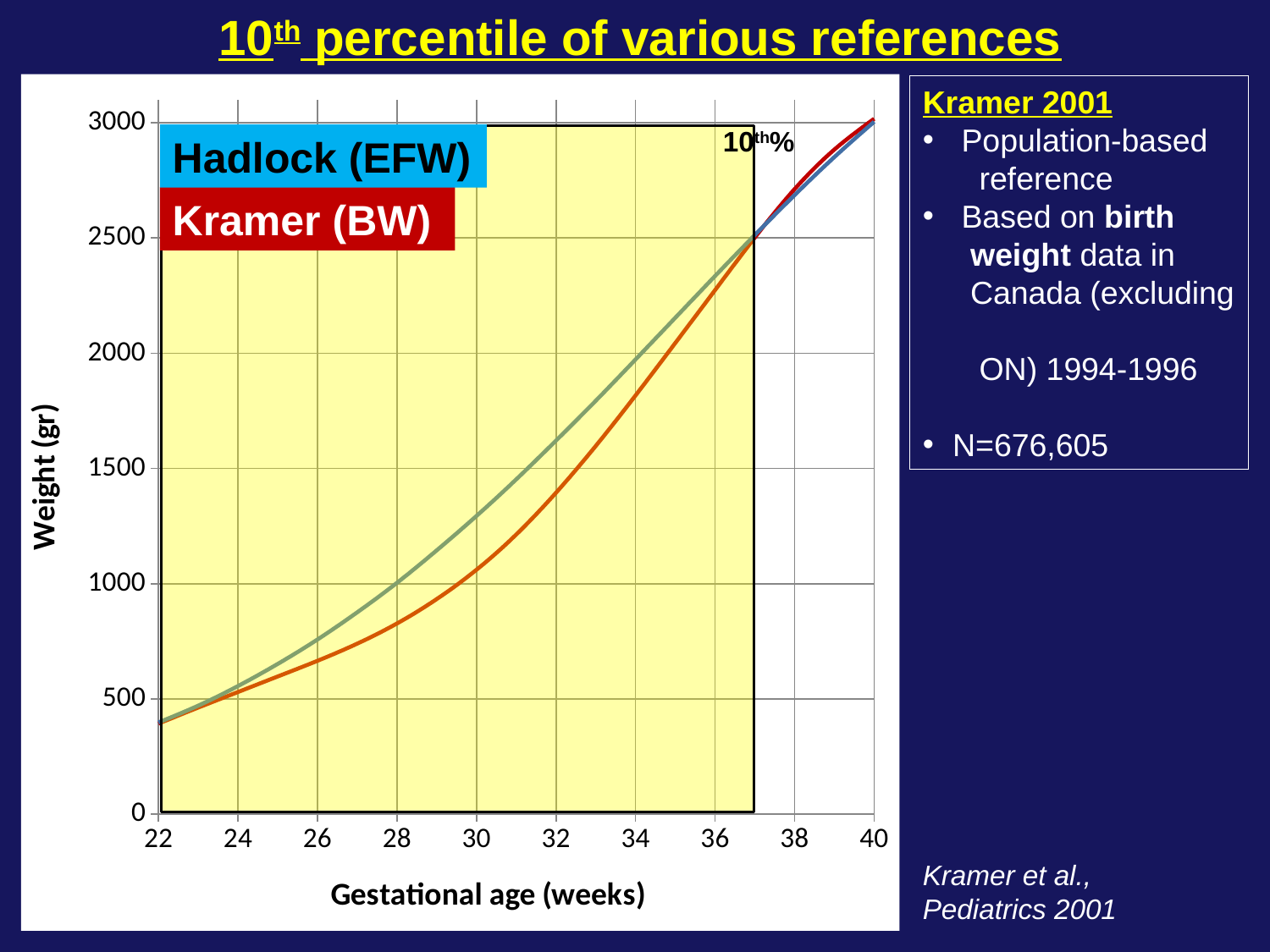
Is the Kramer (BW) value at 30 weeks greater or less than 1500? less What kind of chart is shown on the slide? line chart How many series does the chart show? 2 Is the Hadlock (EFW) value at 32 weeks greater or less than 1500? greater At 32 weeks, which series has the lower weight, Hadlock (EFW) or Kramer (BW)? Kramer (BW) Do the weight values rise or fall as gestational age increases along the x axis? rise Is the Kramer (BW) value at 28 weeks greater or less than 1000? less What is the title of the y axis of the chart? Weight (gr) At 30 weeks, which series has the higher weight, Hadlock (EFW) or Kramer (BW)? Hadlock (EFW) What is the title of the x axis of the chart? Gestational age (weeks)